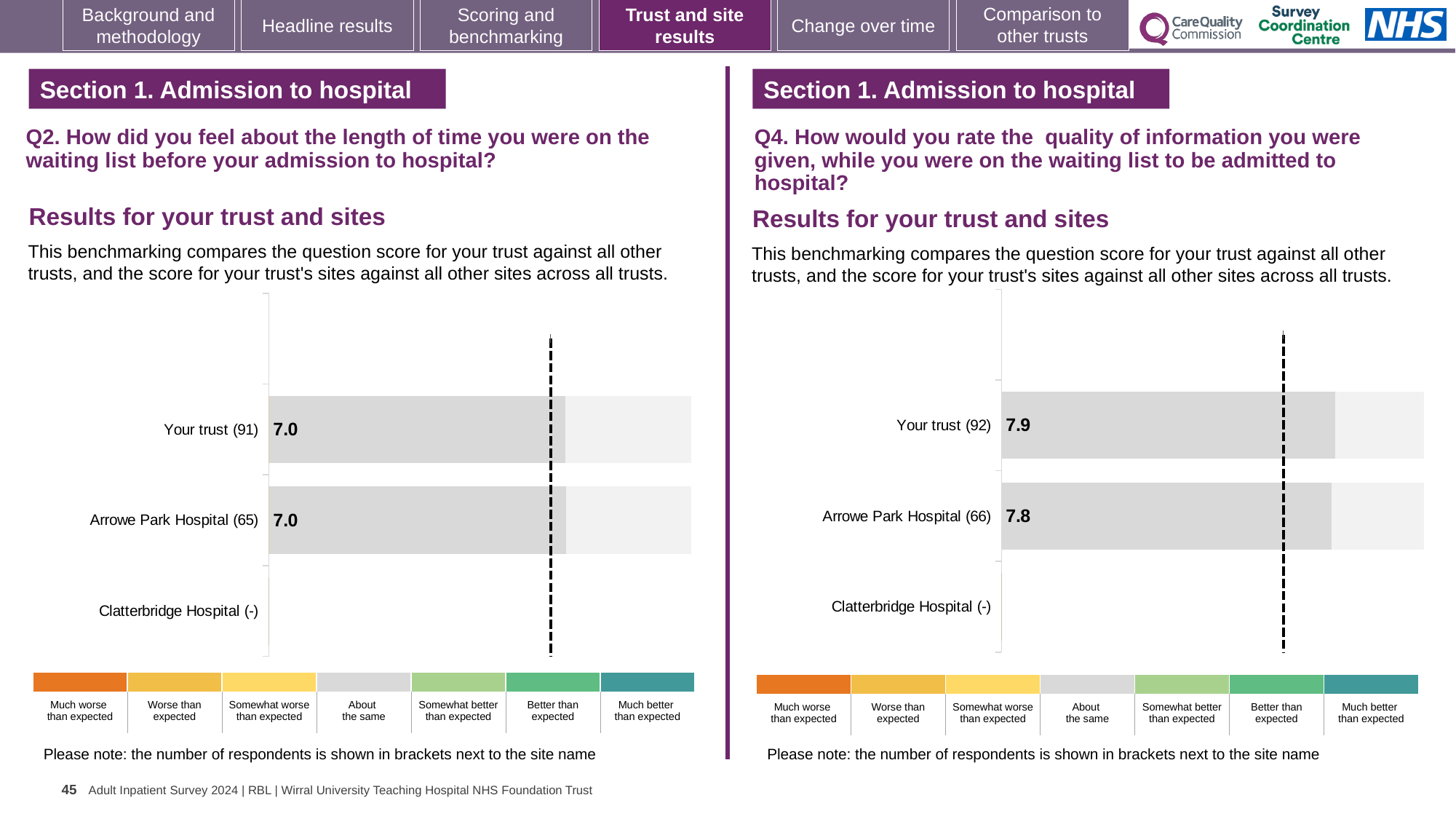
In the Q2 chart on the left, how many site/trust categories are listed on the vertical axis? 3 In the Q2 chart on the left, what is the score for Arrowe Park Hospital (65)? 7.0 In the Q2 chart on the left, what is the score for Your trust (91)? 7.0 In the Q4 chart on the right, what is the score for Arrowe Park Hospital (66)? 7.8 In the Q2 chart on the left, how many respondents are shown in brackets for Arrowe Park Hospital? 65 In the Q2 chart on the left, which category has no score shown? Clatterbridge Hospital (-) In the Q4 chart on the right, how many respondents are shown in brackets for Your trust? 92 What kind of chart is the Q4 chart on the right? Bar chart In the Q4 chart on the right, what is the difference between the score for Your trust (92) and the score for Arrowe Park Hospital (66)? 0.1 In the Q4 chart on the right, what is the score for Your trust (92)? 7.9 In the Q4 chart on the right, which has the higher score: Your trust (92) or Arrowe Park Hospital (66)? Your trust (92)